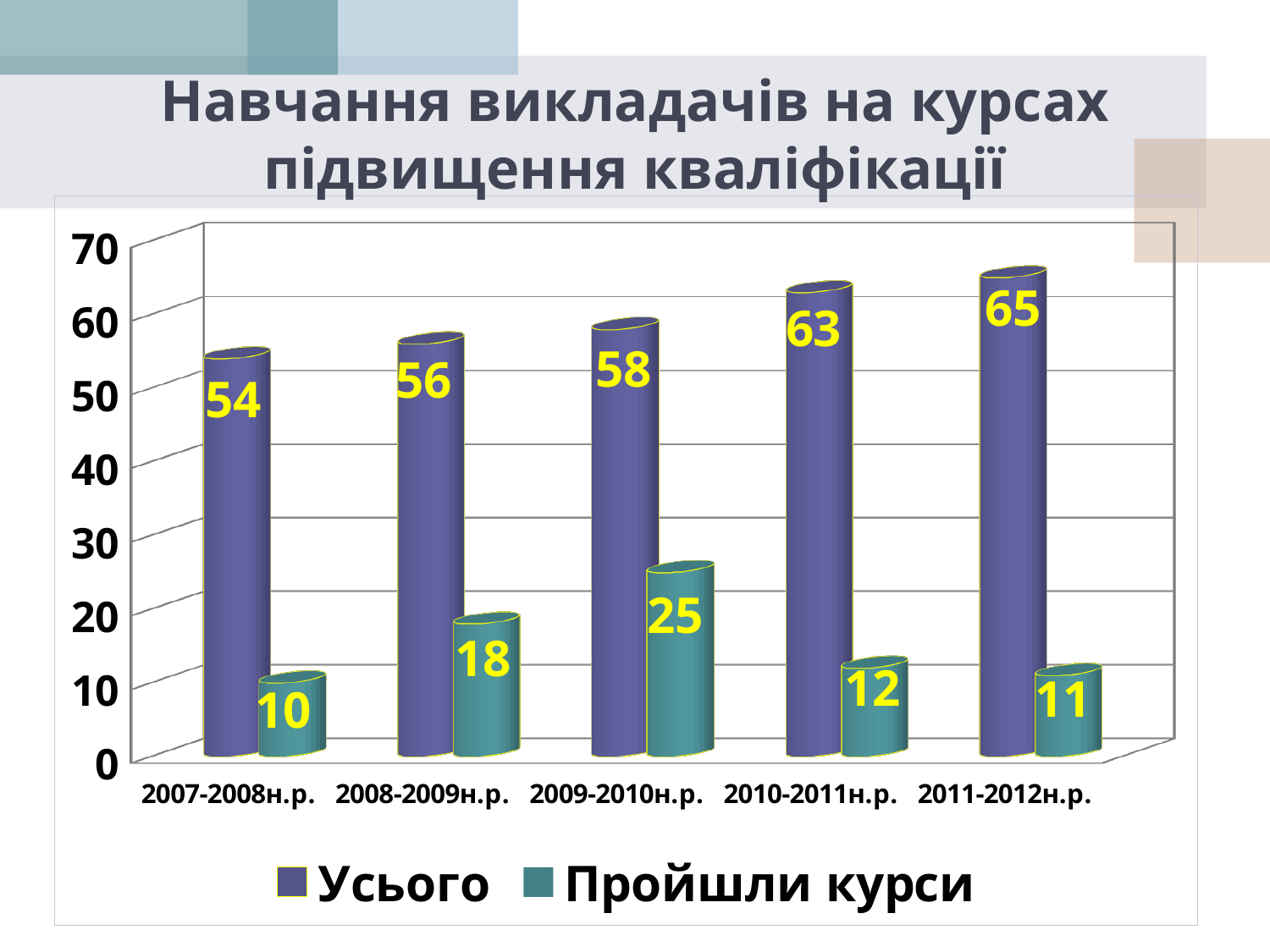
What is the value of Усього for 2007-2008н.р.? 54 What kind of chart is shown? bar chart Which year has the lowest value for Усього? 2007-2008н.р. What is the value of Усього for 2011-2012н.р.? 65 What is the value of Пройшли курси for 2009-2010н.р.? 25 Which is larger: Пройшли курси in 2008-2009н.р. or in 2011-2012н.р.? 2008-2009н.р. How many series does the legend list? 2 What is the difference between Усього and Пройшли курси in 2010-2011н.р.? 51 Which year has the highest value for Пройшли курси? 2009-2010н.р. How many years are shown on the x axis? 5 Does the Усього series rise or fall from 2007-2008н.р. to 2011-2012н.р.? rise What are the two series named in the legend? Усього and Пройшли курси